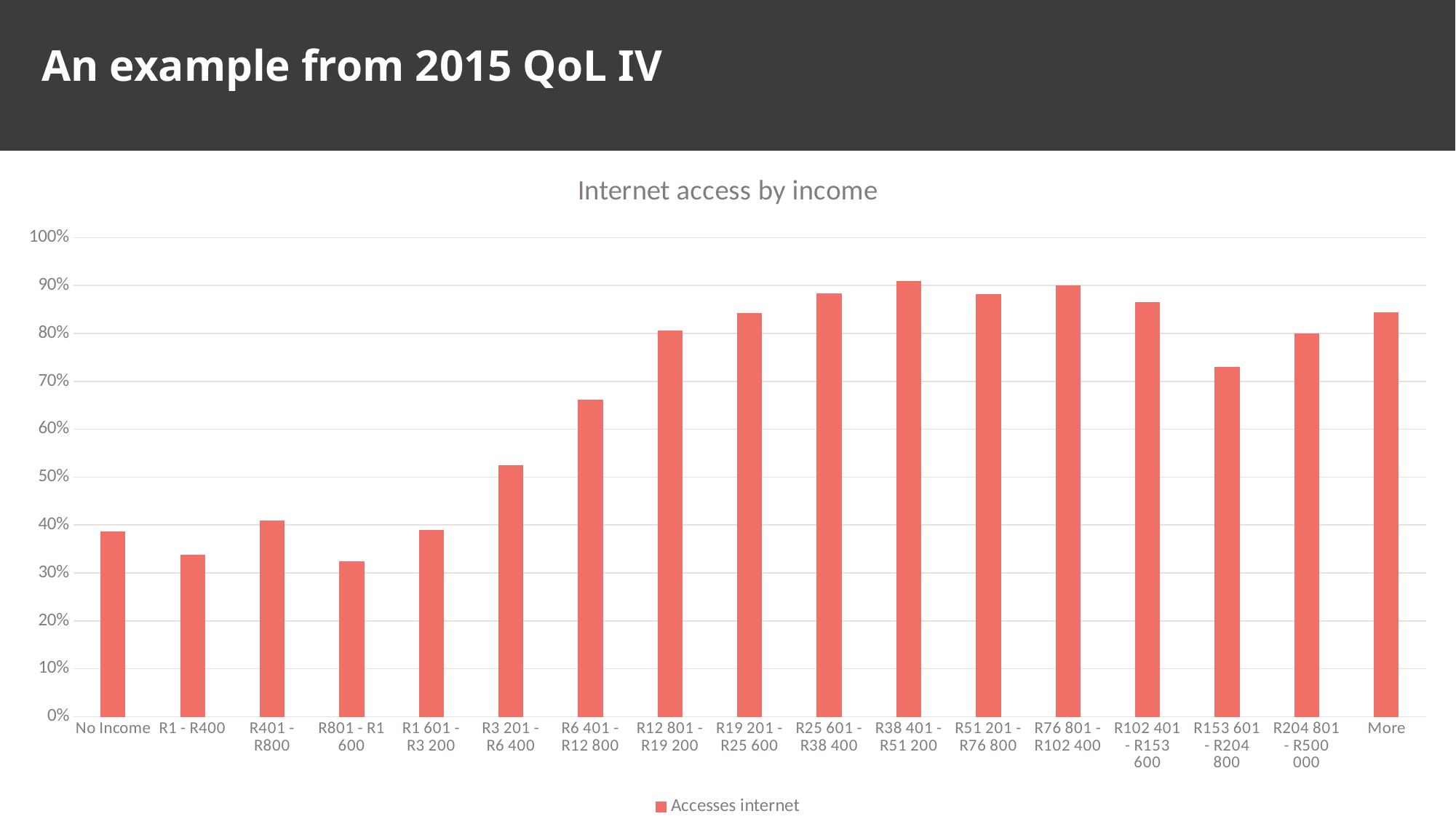
Is the value for No Income greater or less than 40%? less Is the value for R6 401 - R12 800 greater or less than 60%? greater How many income categories are shown on the x axis? 17 What is the title of the chart? Internet access by income Do the values generally rise or fall from R801 - R1 600 to R38 401 - R51 200? rise Which has a higher value, R6 401 - R12 800 or R3 201 - R6 400? R6 401 - R12 800 How many series does the legend list? 1 What kind of chart is shown on the slide? Bar chart Which has a higher value, No Income or R801 - R1 600? No Income Is the value for R153 601 - R204 800 greater or less than 70%? greater